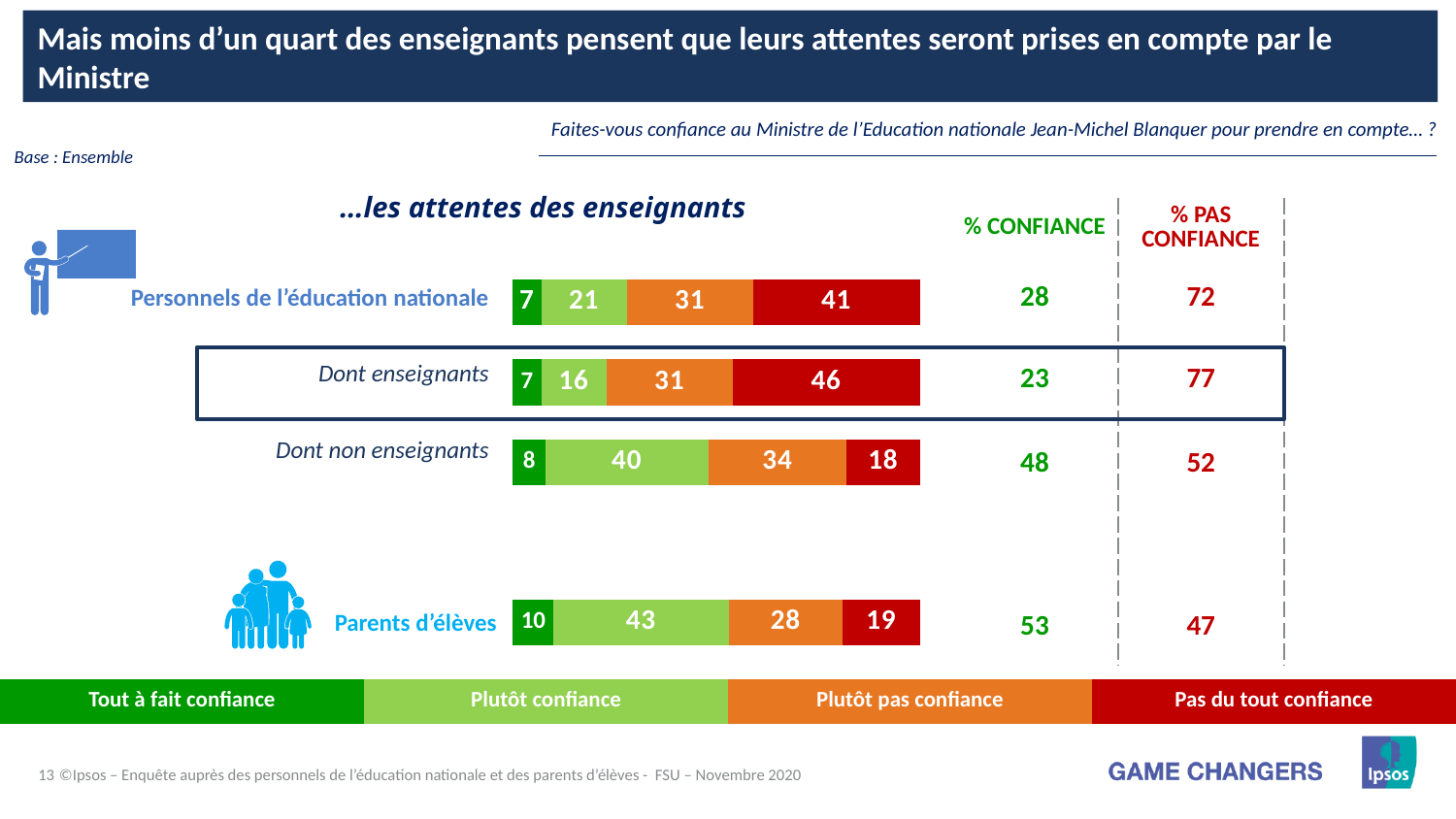
Which is larger: the "Plutôt confiance" value for "Parents d'élèves" or for "Personnels de l'éducation nationale"? Parents d'élèves What is the value of "Plutôt confiance" for "Parents d'élèves"? 43 How many categories are shown in the chart? 4 Which category has the lowest value for "Plutôt confiance"? Dont enseignants What is the value of "Tout à fait confiance" for "Dont non enseignants"? 8 How many series does the legend list? 4 What is the difference between the "Pas du tout confiance" values for "Dont enseignants" and "Dont non enseignants"? 28 Which category has the highest value for "Pas du tout confiance"? Dont enseignants What is the "% CONFIANCE" value shown for "Dont enseignants"? 23 What kind of chart is shown on the slide? Stacked bar chart What is the total of the stacked bar for "Personnels de l'éducation nationale"? 100 What is the value of "Pas du tout confiance" for "Dont enseignants"? 46